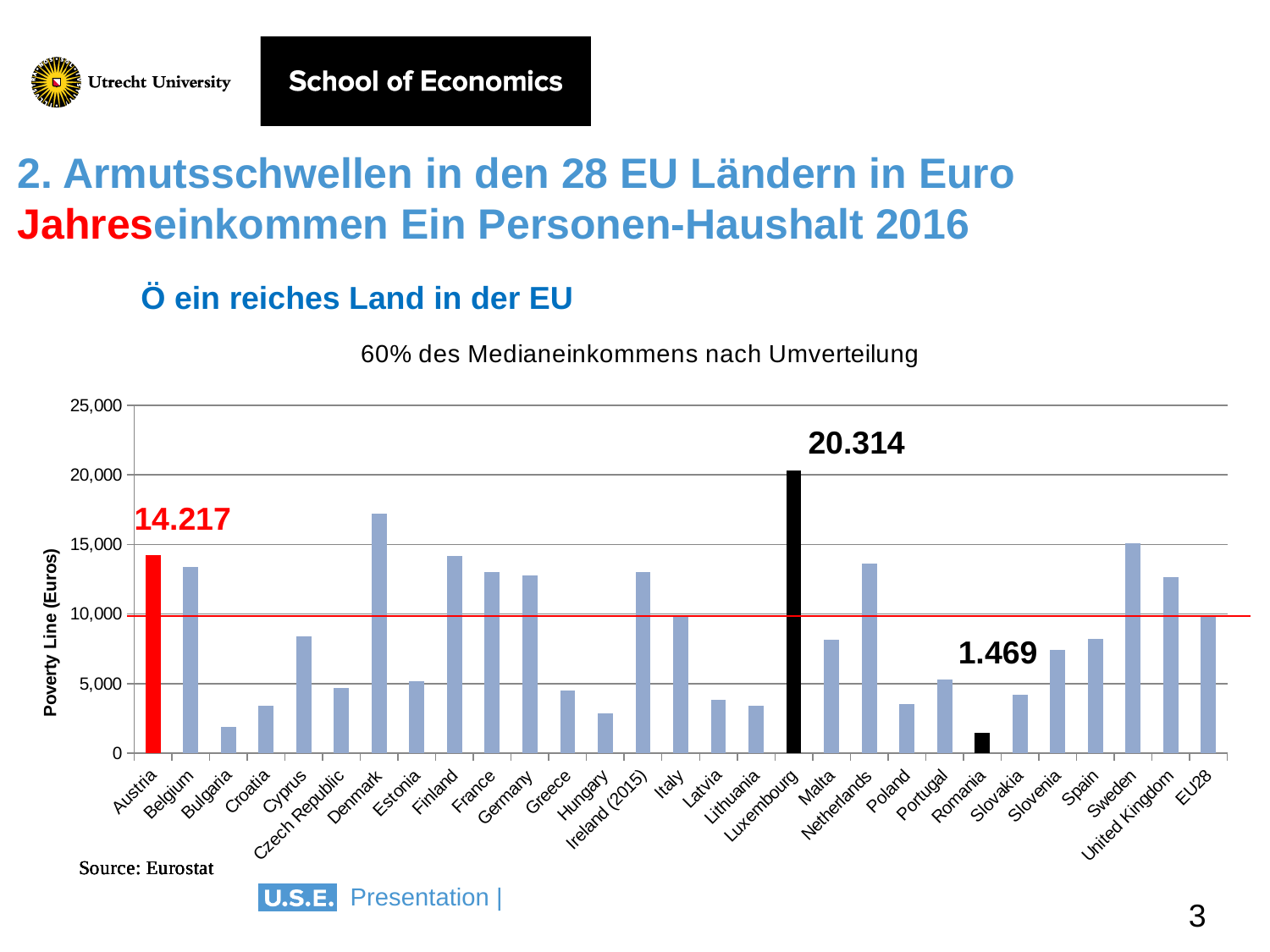
Which is larger, the value for Denmark or the value for Belgium? Denmark Is the value for Denmark greater or less than 15,000? greater Which country has the highest poverty line? Luxembourg What is the value for Austria? 14.217 What kind of chart is shown on the slide? bar chart Which country has the lowest poverty line? Romania What is the value for Romania? 1.469 Is the value for Bulgaria greater or less than 5,000? less What is the value for Luxembourg? 20.314 What is the difference between the values for Luxembourg and Austria? 6.097 What colour is the bar for Austria? red What is the difference between the values for Austria and Romania? 12.748